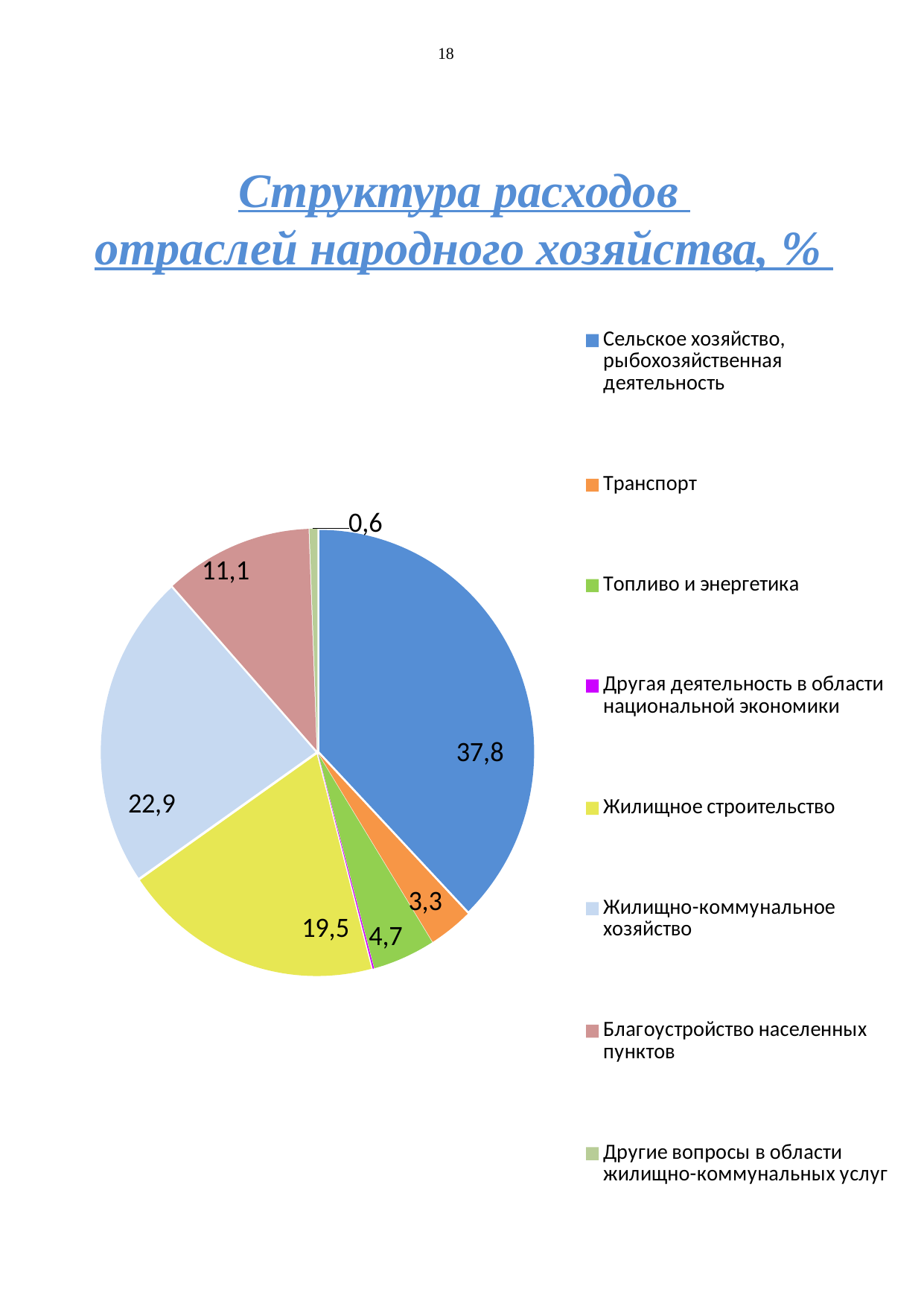
Which is larger, the value for Топливо и энергетика or the value for Транспорт? Топливо и энергетика Which category has the largest share of the pie? Сельское хозяйство, рыбохозяйственная деятельность What is the difference between the values for Благоустройство населенных пунктов and Топливо и энергетика? 6,4 How many categories does the legend list? 8 What is the title of the chart? Структура расходов отраслей народного хозяйства, % What kind of chart is shown on the slide? pie chart What is the difference between the values for Сельское хозяйство, рыбохозяйственная деятельность and Жилищно-коммунальное хозяйство? 14,9 What is the value for Жилищно-коммунальное хозяйство? 22,9 What is the value for Транспорт? 3,3 What is the value for Благоустройство населенных пунктов? 11,1 What is the value for Сельское хозяйство, рыбохозяйственная деятельность? 37,8 What is the value for Жилищное строительство? 19,5